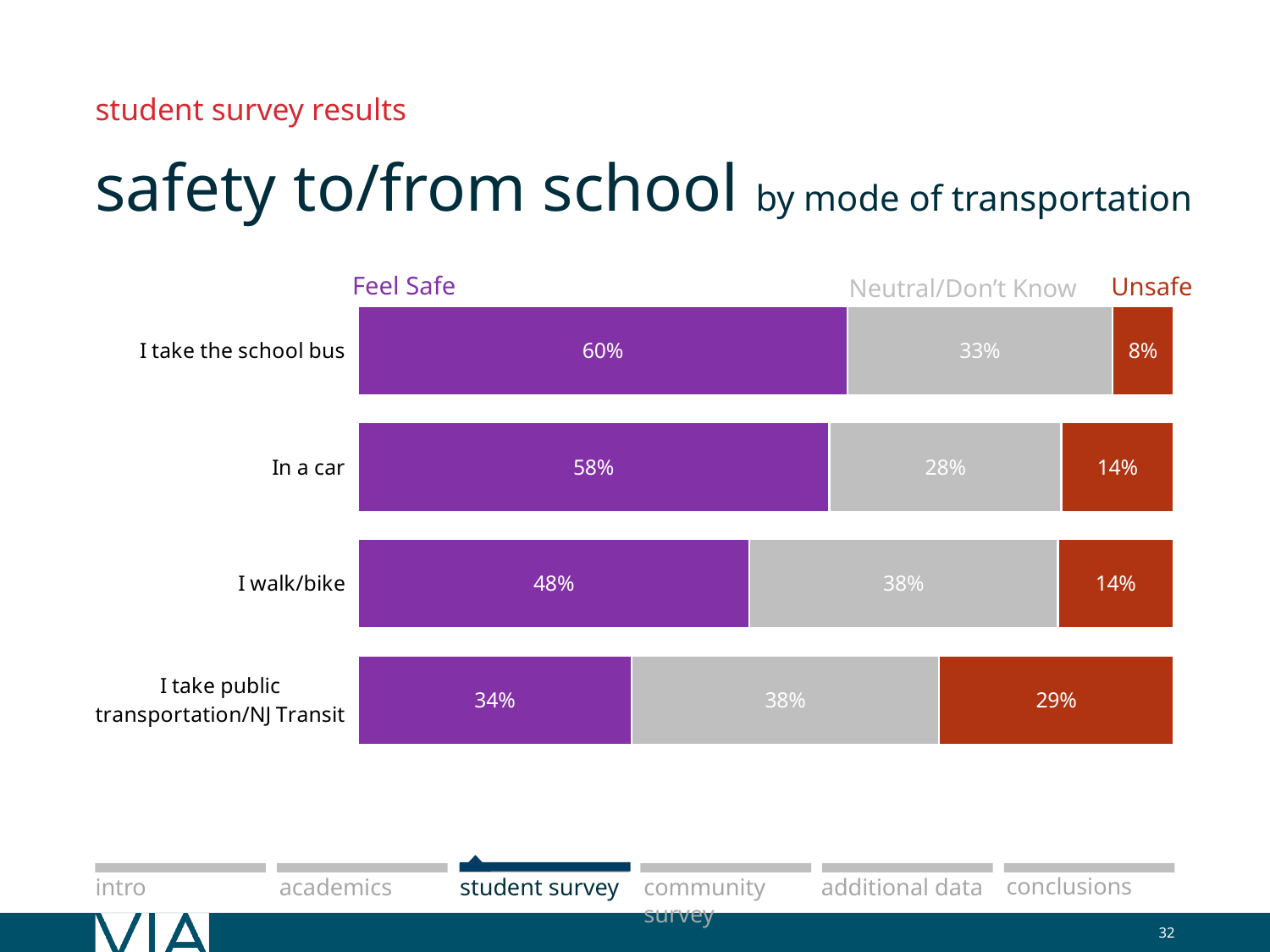
How many modes of transportation are shown in the chart? 4 What is the Neutral/Don't Know value for students who walk/bike? 38% What is the Unsafe value for students who take public transportation/NJ Transit? 29% How many series does the chart show? 3 What type of chart is shown on the slide? Stacked bar chart Which mode of transportation has the highest Feel Safe percentage? I take the school bus Which mode of transportation has the highest Unsafe percentage? I take public transportation/NJ Transit Which is larger: the Feel Safe percentage for 'In a car' or for 'I walk/bike'? In a car What percentage of students who take the school bus feel safe? 60% What colour represents the Unsafe series? Red What is the difference between the Feel Safe percentage for the school bus and for walking/biking? 12% Which mode of transportation has the lowest Feel Safe percentage? I take public transportation/NJ Transit